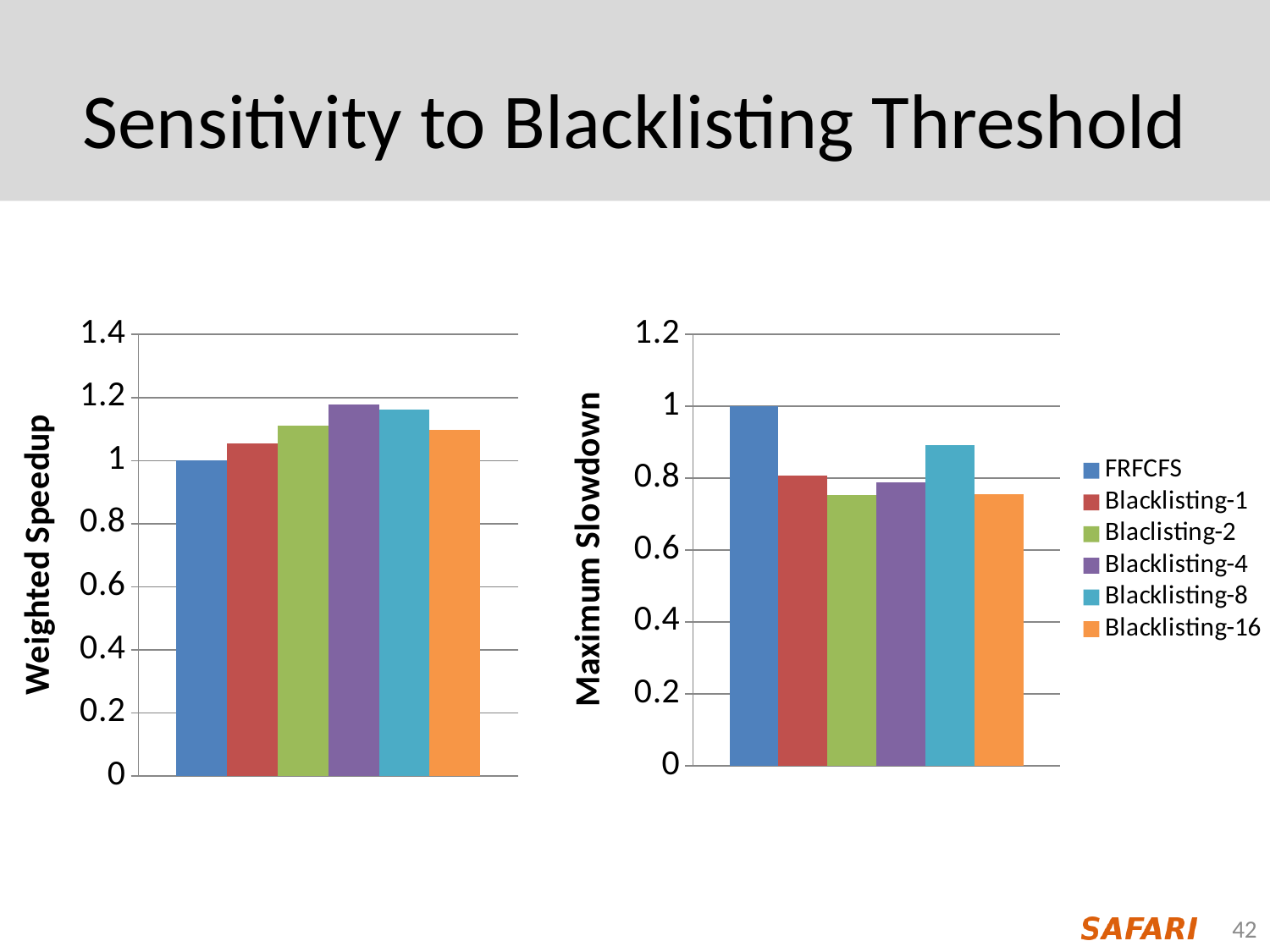
In the Maximum Slowdown chart on the right, is the value for Blaclisting-2 greater or less than 0.8? less In the Weighted Speedup chart on the left, which series has the lowest value? FRFCFS How many series does the legend list? 6 In the Maximum Slowdown chart on the right, what is the value for FRFCFS? 1 In the Maximum Slowdown chart on the right, is the value for Blacklisting-8 greater or less than 0.8? greater In the Maximum Slowdown chart on the right, which is larger, Blacklisting-4 or Blacklisting-8? Blacklisting-8 How many bars are plotted in the Maximum Slowdown chart on the right? 6 In the Weighted Speedup chart on the left, which is larger, FRFCFS or Blacklisting-1? Blacklisting-1 What kind of chart is the Weighted Speedup chart on the left? bar chart In the Weighted Speedup chart on the left, is the value for Blacklisting-4 greater or less than 1? greater In the Weighted Speedup chart on the left, what is the value for FRFCFS? 1 In the Maximum Slowdown chart on the right, which series has the highest value? FRFCFS